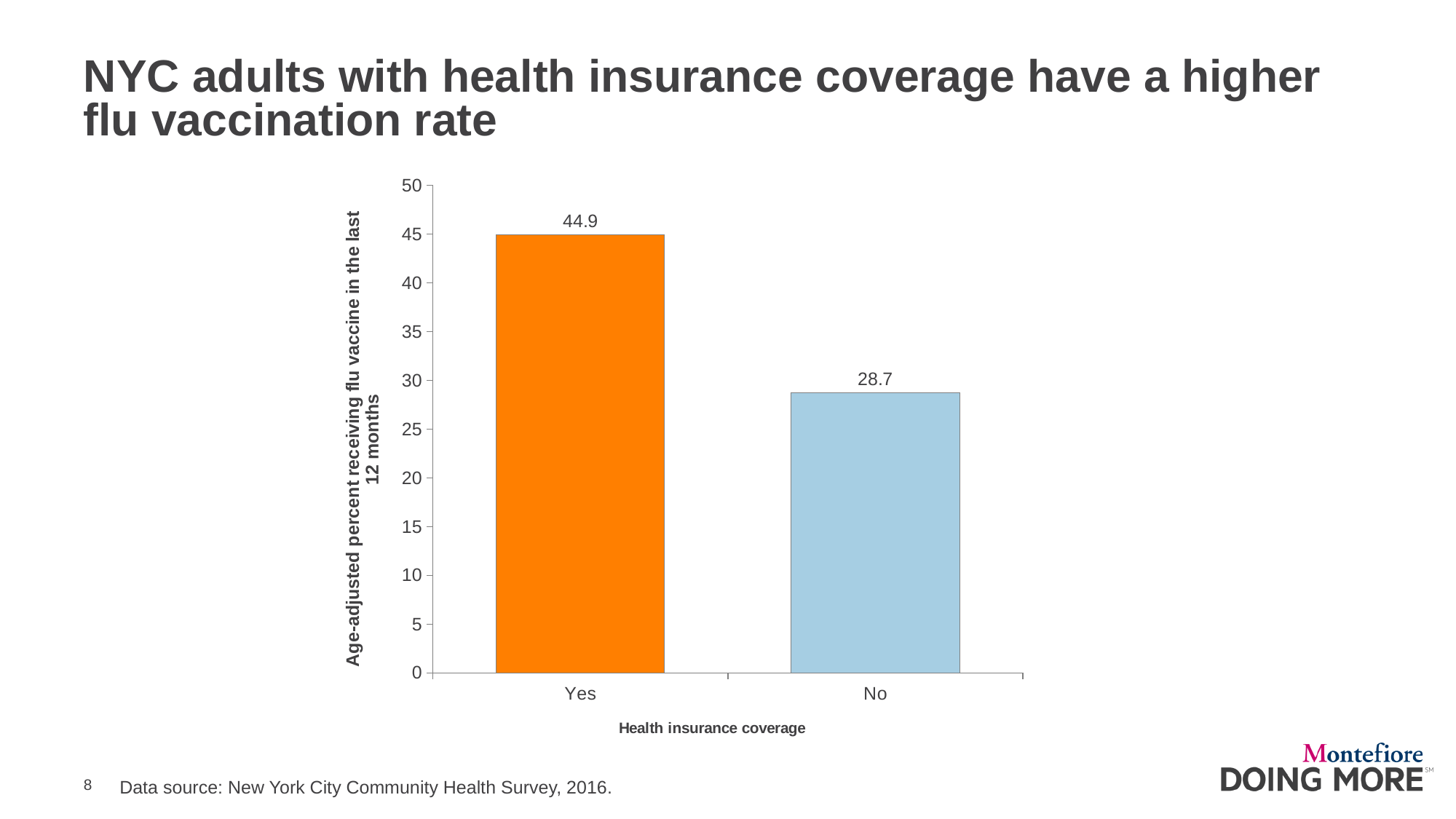
What is the age-adjusted percent receiving flu vaccine for adults without health insurance coverage (No)? 28.7 What colour is the bar for the Yes category? Orange Is the value for the Yes group greater or less than 40? greater Is the value for the No group greater or less than 30? less What kind of chart is shown on the slide? Bar chart Is the flu vaccination rate higher for the Yes group or the No group? Yes What is the label of the x axis of the chart? Health insurance coverage What is the difference in flu vaccination rate between the Yes and No health insurance coverage groups? 16.2 Which health insurance coverage category has the higher flu vaccination rate? Yes How many categories are shown on the x axis of the chart? 2 Which health insurance coverage category has the lower flu vaccination rate? No What is the age-adjusted percent receiving flu vaccine for adults with health insurance coverage (Yes)? 44.9